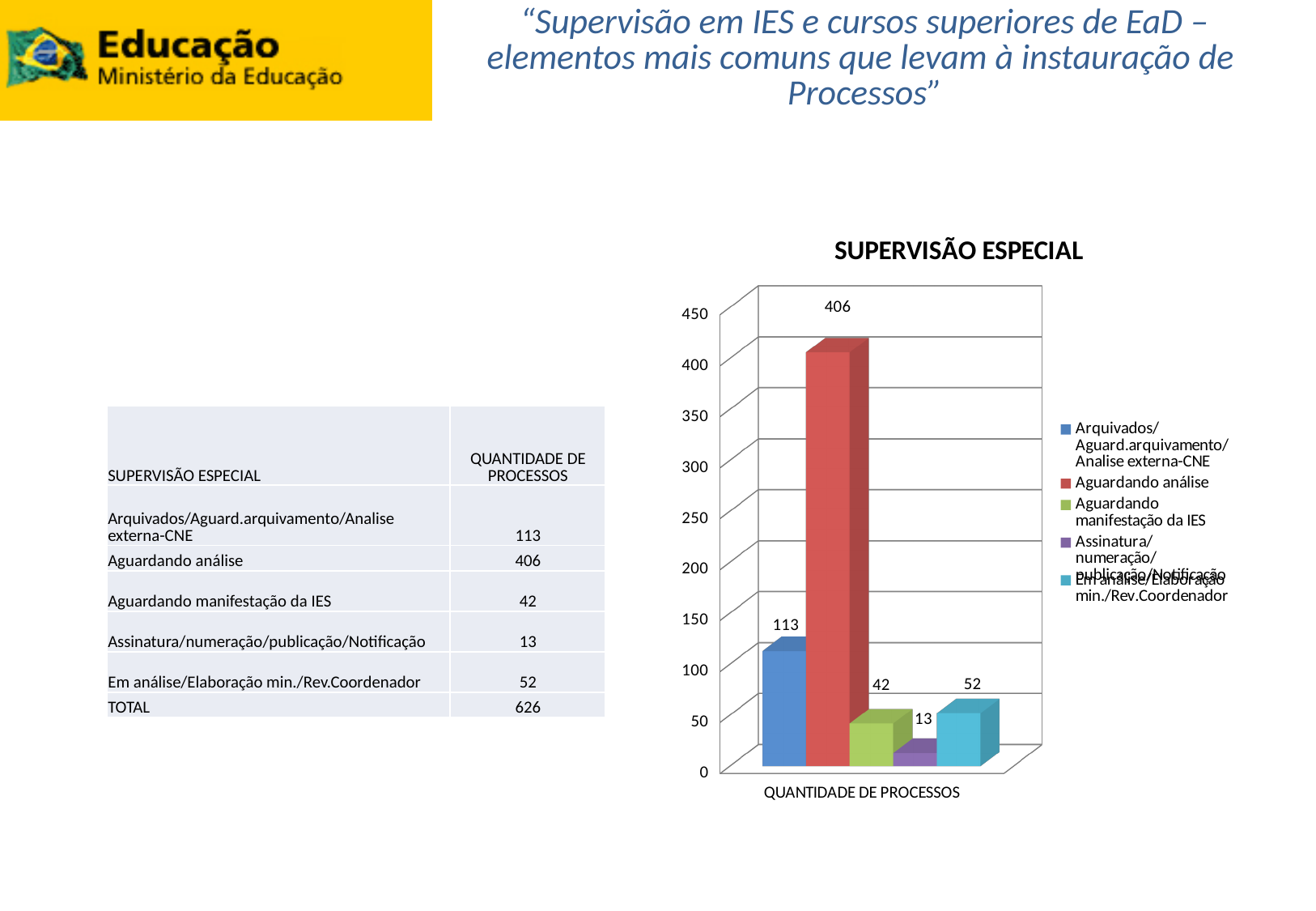
What is the value for Aguardando manifestação da IES in the chart? 42 What is the difference between the values for Aguardando análise and Arquivados/Aguard.arquivamento/Analise externa-CNE? 293 What is the value for Aguardando análise in the SUPERVISÃO ESPECIAL chart? 406 What is the total of all the values plotted in the SUPERVISÃO ESPECIAL chart? 626 Which series has the highest value in the SUPERVISÃO ESPECIAL chart? Aguardando análise Which series has the lowest value in the SUPERVISÃO ESPECIAL chart? Assinatura/numeração/publicação/Notificação How many series does the legend of the SUPERVISÃO ESPECIAL chart list? 5 What is the title of the chart on the slide? SUPERVISÃO ESPECIAL What kind of chart is shown on the slide? bar chart Which is larger: the value for Aguardando manifestação da IES or for Em análise/Elaboração min./Rev.Coordenador? Em análise/Elaboração min./Rev.Coordenador Is the value for Arquivados/Aguard.arquivamento/Analise externa-CNE greater or less than 100? greater What is the value for Em análise/Elaboração min./Rev.Coordenador in the chart? 52